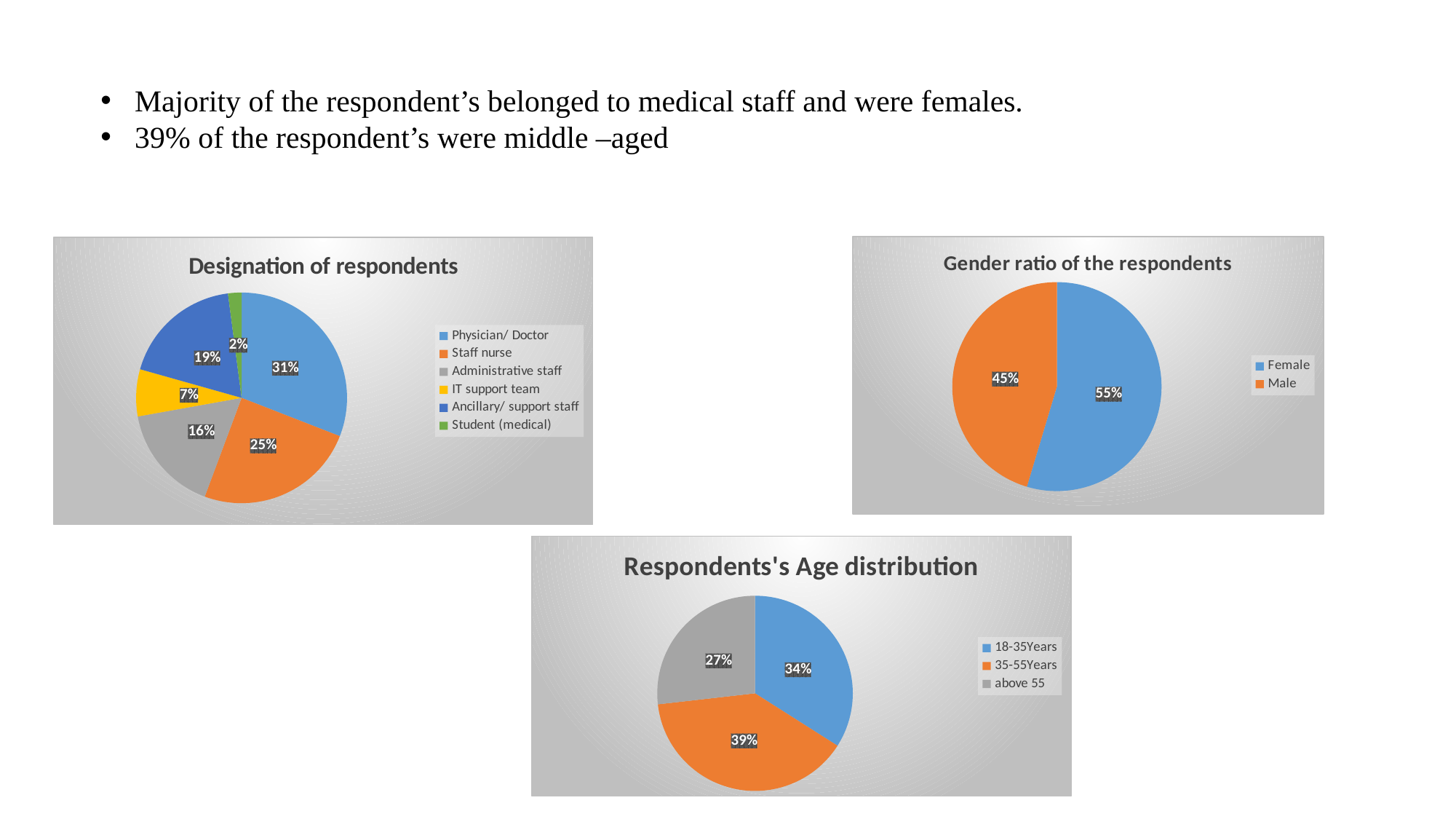
In the 'Designation of respondents' chart, which designation has the largest share? Physician/ Doctor In the 'Respondents's Age distribution' chart, which age group has the smallest share? above 55 In the 'Respondents's Age distribution' chart, what is the difference between the 18-35Years share and the above 55 share? 7% In the 'Designation of respondents' chart, which designation has the smallest share? Student (medical) In the 'Designation of respondents' chart, what is the difference between the Ancillary/ support staff share and the IT support team share? 12% In the 'Gender ratio of the respondents' chart, what share of respondents are Female? 55% In the 'Respondents's Age distribution' chart, what share of respondents are 35-55Years? 39% What kind of chart is 'Gender ratio of the respondents'? Pie chart In the 'Gender ratio of the respondents' chart, which is larger, the Female share or the Male share? Female In the 'Designation of respondents' chart, what share of respondents are Staff nurse? 25% In the 'Designation of respondents' chart, what share of respondents are Physician/ Doctor? 31% In the 'Designation of respondents' chart, how many categories does the legend list? 6